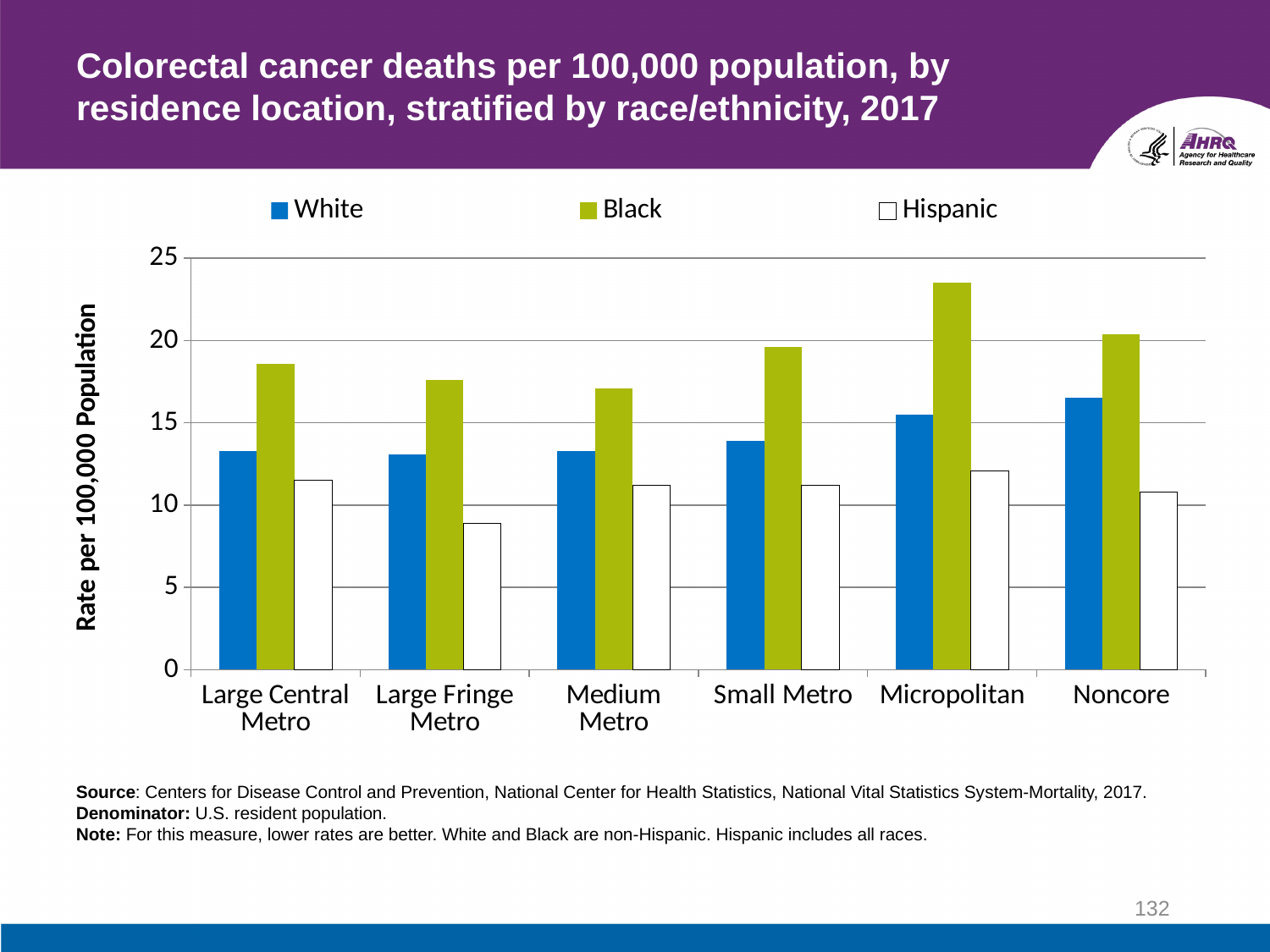
Is the Black rate for Large Central Metro greater or less than 20? less How many residence location categories are shown on the x axis? 6 In the Noncore category, which is larger: the White rate or the Black rate? Black Is the White rate for Noncore greater or less than 15? greater Is the Hispanic rate for Large Fringe Metro greater or less than 10? less For which residence location is the Hispanic rate lowest? Large Fringe Metro For which residence location is the Black rate highest? Micropolitan For which residence location is the White rate highest? Noncore How many series does the legend list? 3 Which series is shown with white (unfilled) bars? Hispanic What type of chart is shown on the slide? bar chart